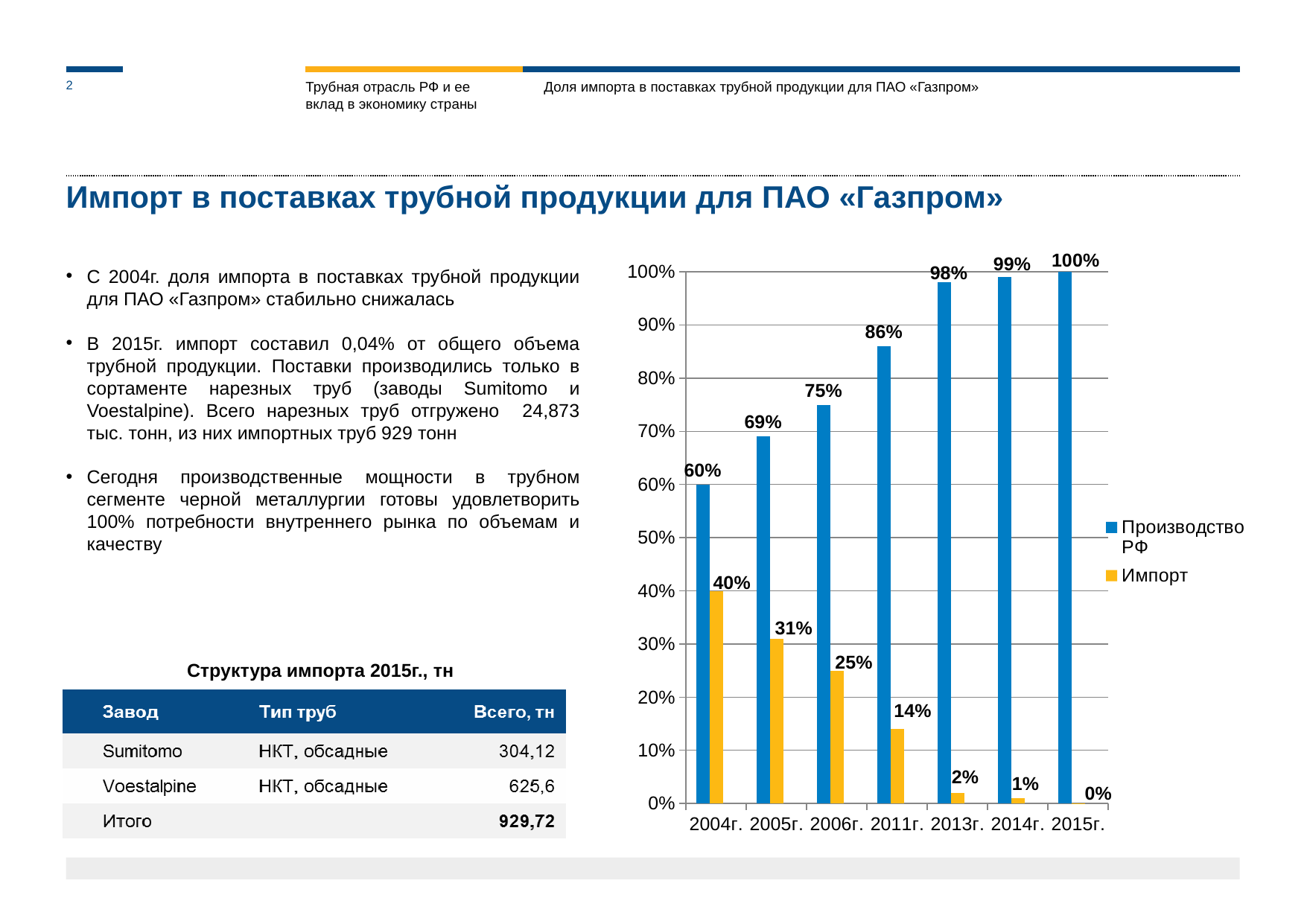
Which is larger in 2004г., Производство РФ or Импорт? Производство РФ What kind of chart is shown on the slide? bar chart What is the value for Производство РФ in 2004г.? 60% How many years are shown on the x axis of the chart? 7 What is the value for Импорт in 2006г.? 25% How many series does the chart legend list? 2 In which year is the Производство РФ value lowest? 2004г. Does the Импорт value rise or fall from 2004г. to 2015г.? fall What is the value for Производство РФ in 2013г.? 98% What is the difference between Производство РФ and Импорт in 2005г.? 38% What is the value for Импорт in 2011г.? 14% In which year is the Импорт value highest? 2004г.